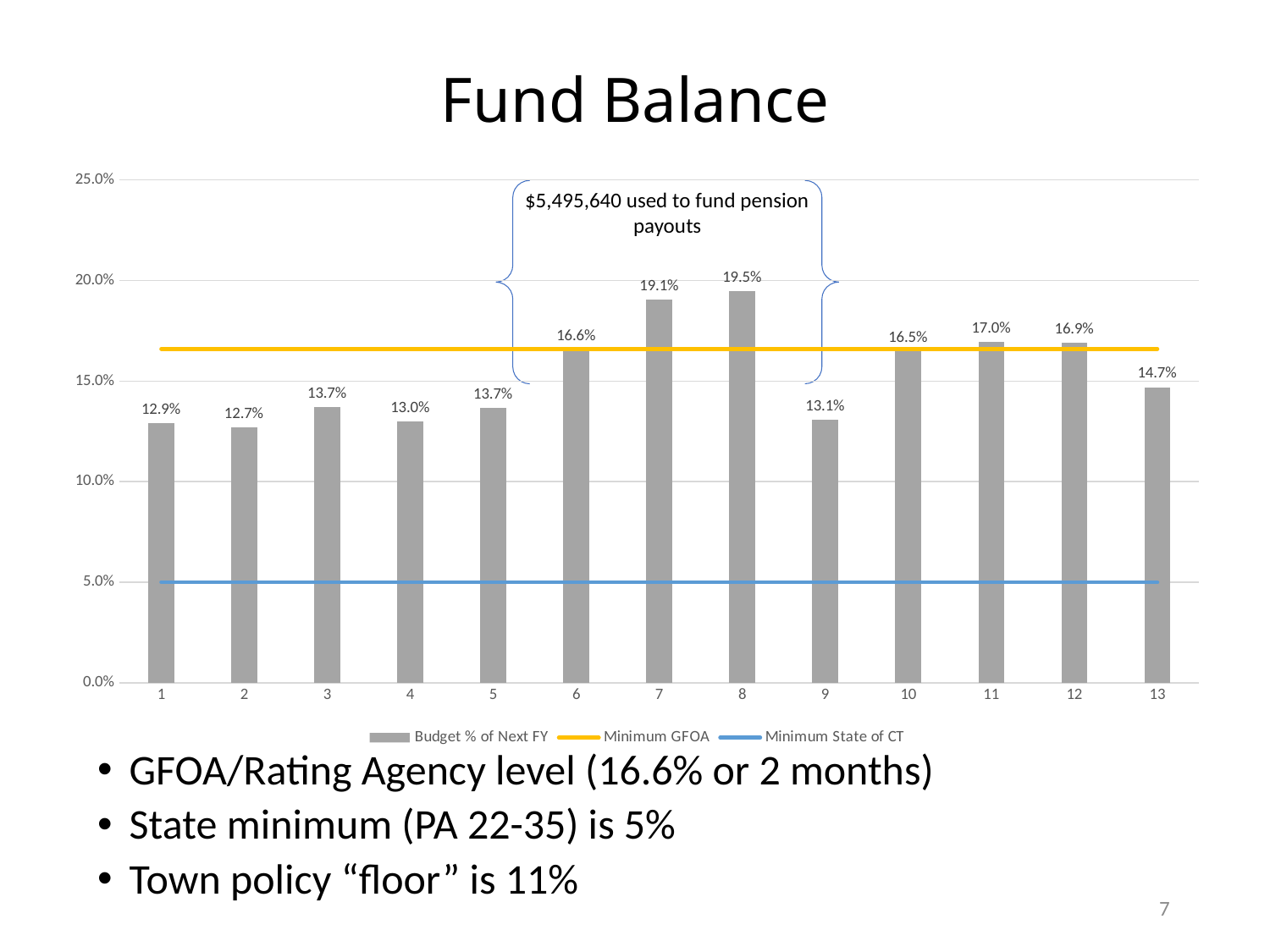
Is the Budget % of Next FY value for category 9 greater or less than 15.0%? less How many categories are shown on the x axis? 13 What is the title of the chart? Fund Balance What is the Budget % of Next FY value for category 1? 12.9% What is the Budget % of Next FY value for category 8? 19.5% How many series does the legend list? 3 Which is larger, the Budget % of Next FY for category 7 or for category 10? 7 What is the Budget % of Next FY value for category 13? 14.7% What kind of chart is used to show the Budget % of Next FY series? bar chart Which category has the lowest Budget % of Next FY? 2 Which category has the highest Budget % of Next FY? 8 What is the difference between the Budget % of Next FY values for categories 8 and 2? 6.8%